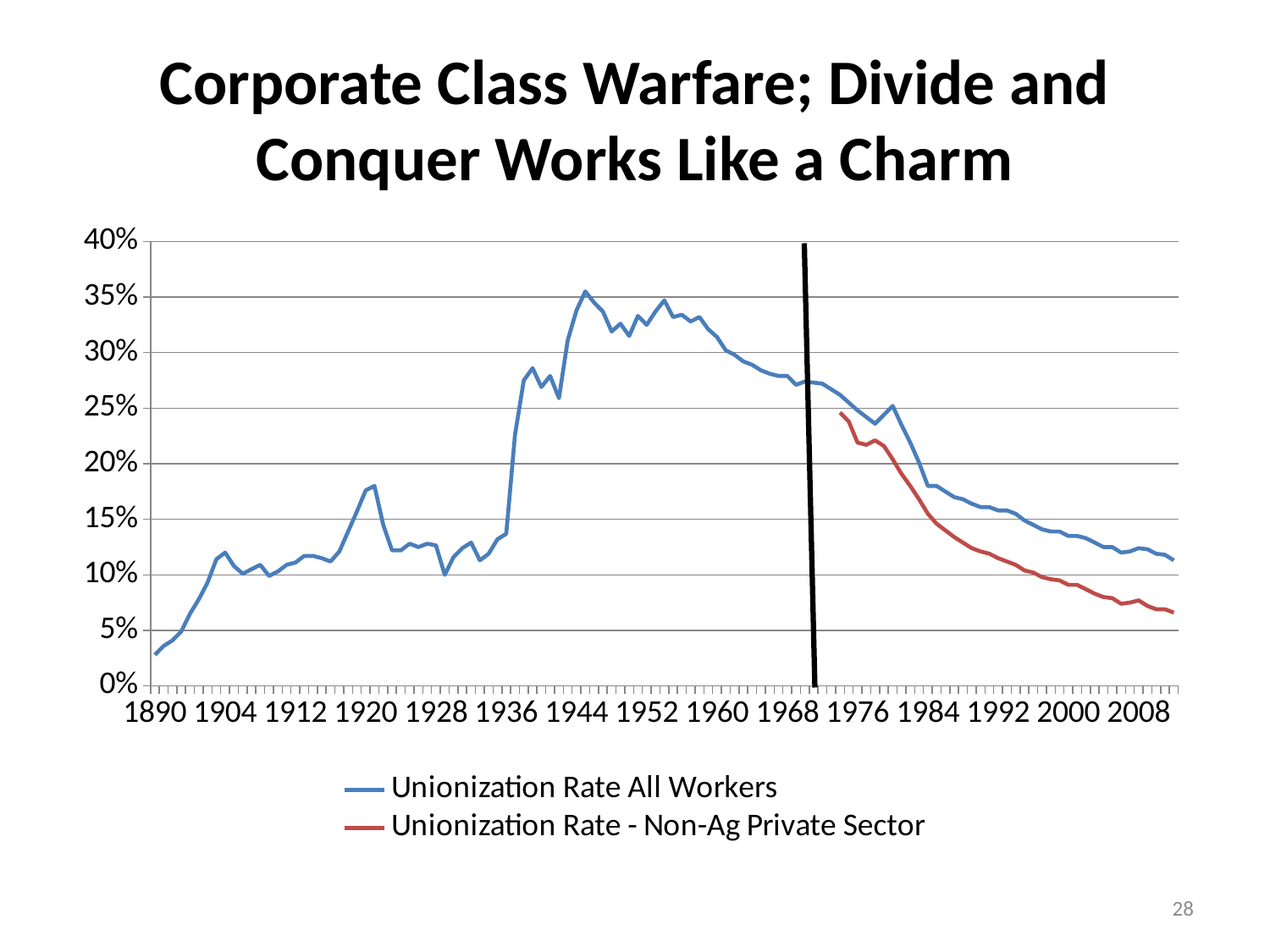
In 2008, which series has the higher value: Unionization Rate All Workers or Unionization Rate - Non-Ag Private Sector? Unionization Rate All Workers Is the value for Unionization Rate - Non-Ag Private Sector in 2008 greater or less than 10%? less Is the value for Unionization Rate All Workers in 1920 greater or less than 15%? greater Is the value for Unionization Rate All Workers in 1890 greater or less than 5%? less Which series is drawn in red? Unionization Rate - Non-Ag Private Sector How many series does the legend list? 2 Does the Unionization Rate All Workers series rise or fall between 1890 and 1904? rise What is the title of the slide's chart? Corporate Class Warfare; Divide and Conquer Works Like a Charm Does the Unionization Rate All Workers series rise or fall between 1976 and 2008? fall What kind of chart is shown on the slide? line chart